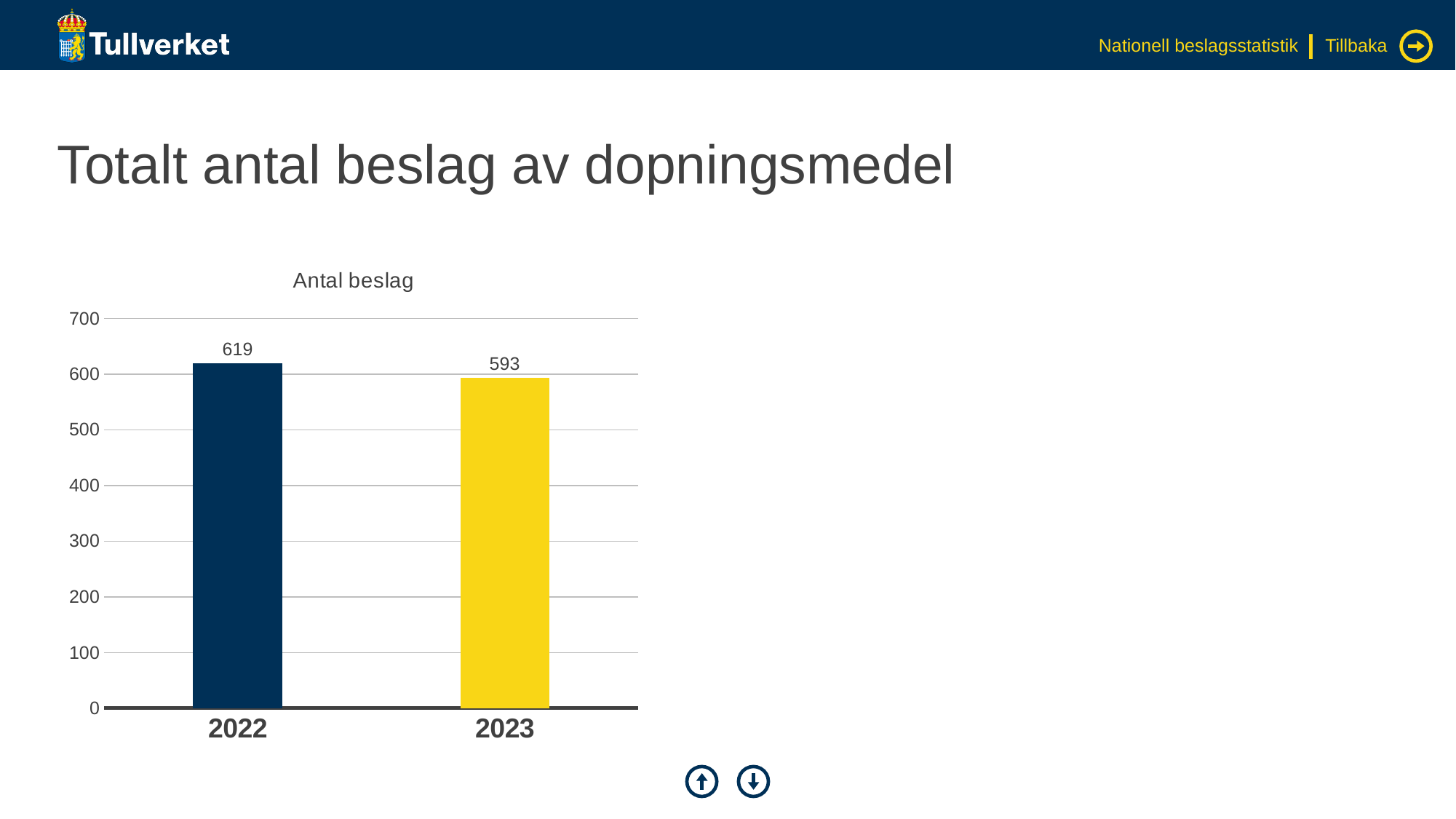
What is the value for 2023? 593 Do the values rise or fall from 2022 to 2023? fall What is the value for 2022? 619 Is the value for 2023 greater or less than 600? less What is the title of the chart? Antal beslag Which year has the lowest number of seizures? 2023 Is the value for 2022 greater or less than 600? greater How many years are shown on the chart? 2 What kind of chart is shown on the slide? bar chart Which is larger, the value for 2022 or the value for 2023? 2022 Which year has the highest number of seizures? 2022 What is the difference between the values for 2022 and 2023? 26